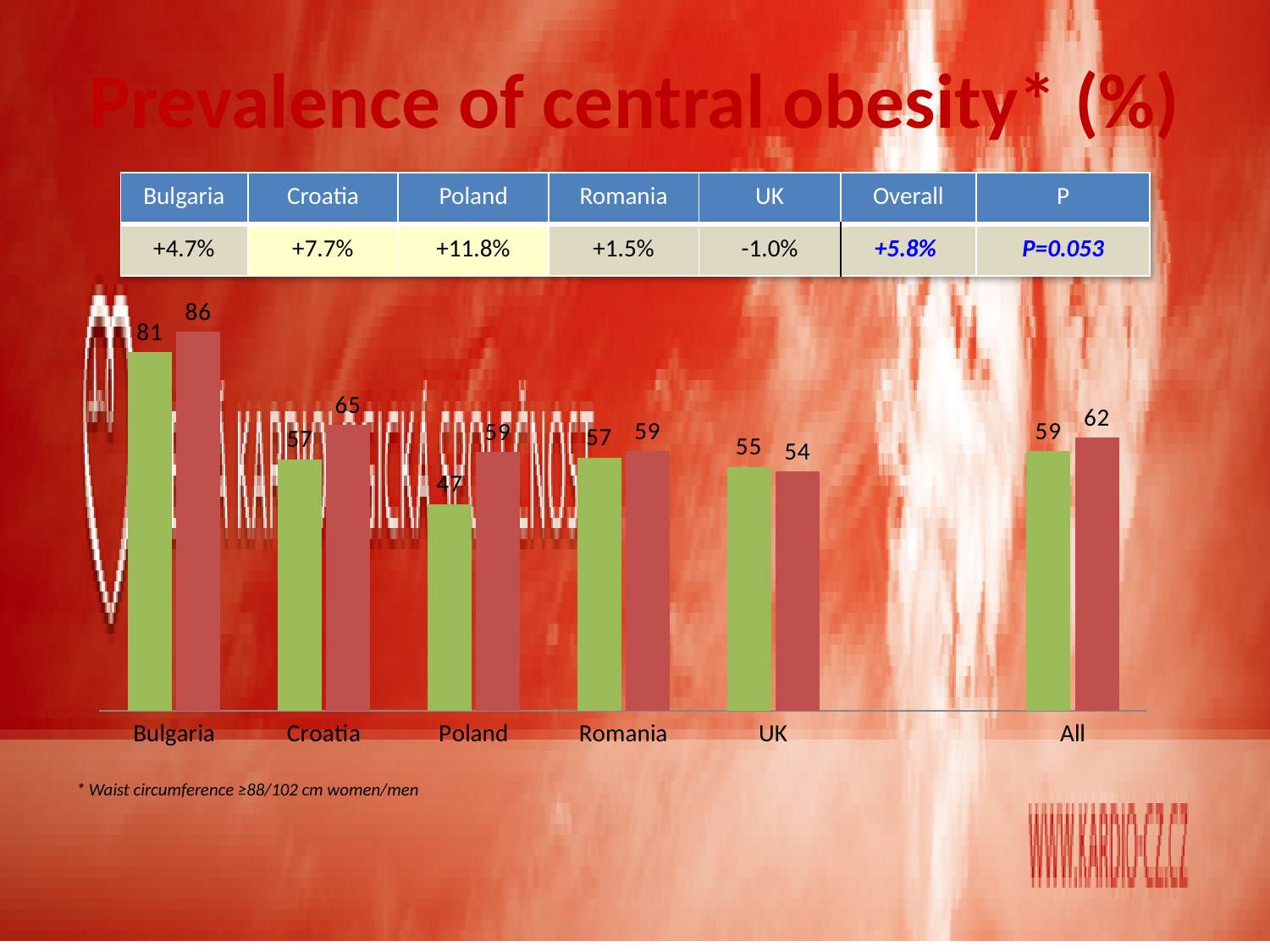
What is the value of the green bar for Poland? 47 Which category has the lowest green bar? Poland What is the difference between the red bar for Bulgaria and the red bar for Poland? 27 What type of chart is shown on the slide? bar chart How many countries/categories are shown on the x axis of the chart? 6 What is the title of the chart on the slide? Prevalence of central obesity* (%) For the UK, which bar is larger, the green bar or the red bar? green bar Which category has the highest red bar? Bulgaria What is the value of the red bar for Poland? 59 What is the value of the red bar for All? 62 What is the difference between the red and green bars for Croatia? 8 What is the value of the green bar for Bulgaria? 81